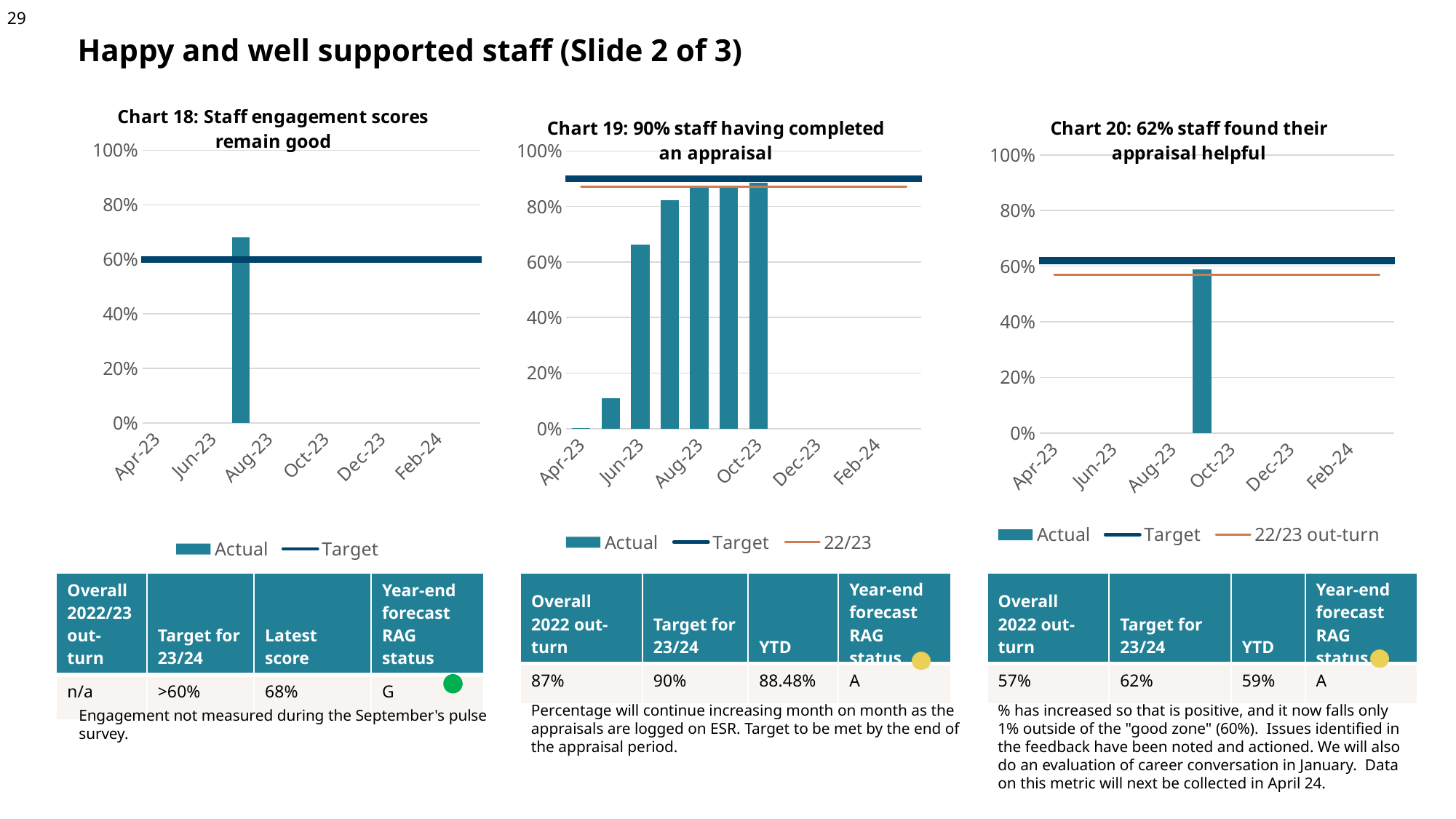
How many series does the legend of Chart 19 list? 3 In Chart 19, is the Actual value for May-23 greater or less than 20%? less How many series does the legend of Chart 18 list? 2 In Chart 19, which has the larger Actual value, May-23 or Jun-23? Jun-23 In Chart 18, at what value does the Target line sit? 60% What kind of chart is Chart 18: Staff engagement scores remain good? Combination bar and line chart How many Actual bars are plotted in Chart 20? 1 In Chart 19, do the Actual bars rise or fall from Apr-23 to Oct-23? rise What are the legend entries of Chart 19? Actual, Target, 22/23 In Chart 19, is the Actual value for Jun-23 greater or less than 40%? greater